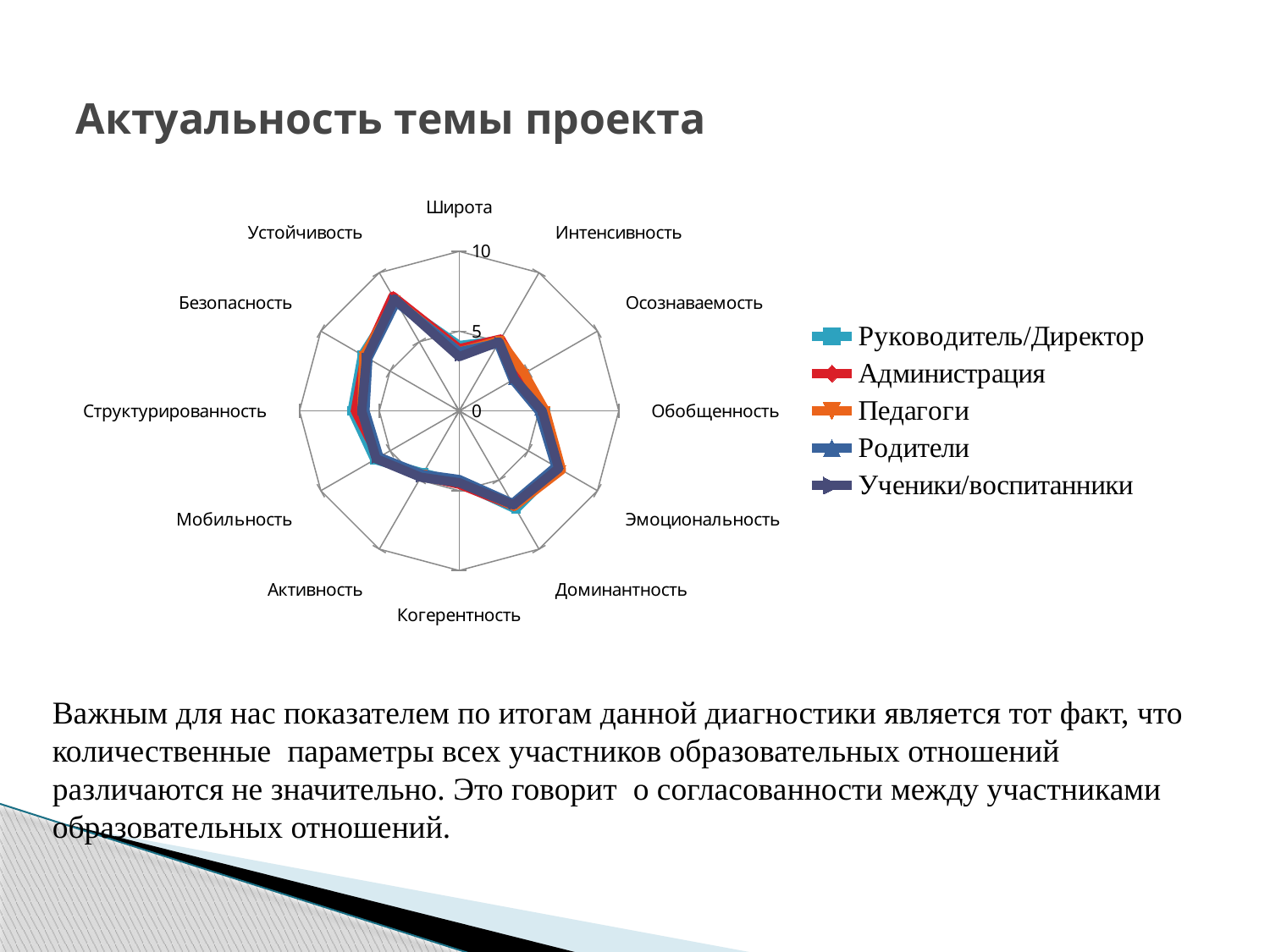
Is the value for Эмоциональность greater or less than 5? greater Which category has the lowest values across the series? Широта How many categories (axes) does the radar chart have? 12 Which series is shown in orange in the legend? Педагоги Is the value for Структурированность greater or less than 5? greater Is the value for Безопасность greater or less than 5? greater How many series does the legend list? 5 Which is larger, the value for Структурированность or the value for Широта? Структурированность What is the maximum value shown on the radar chart's axis scale? 10 What kind of chart is shown on the slide? Radar chart